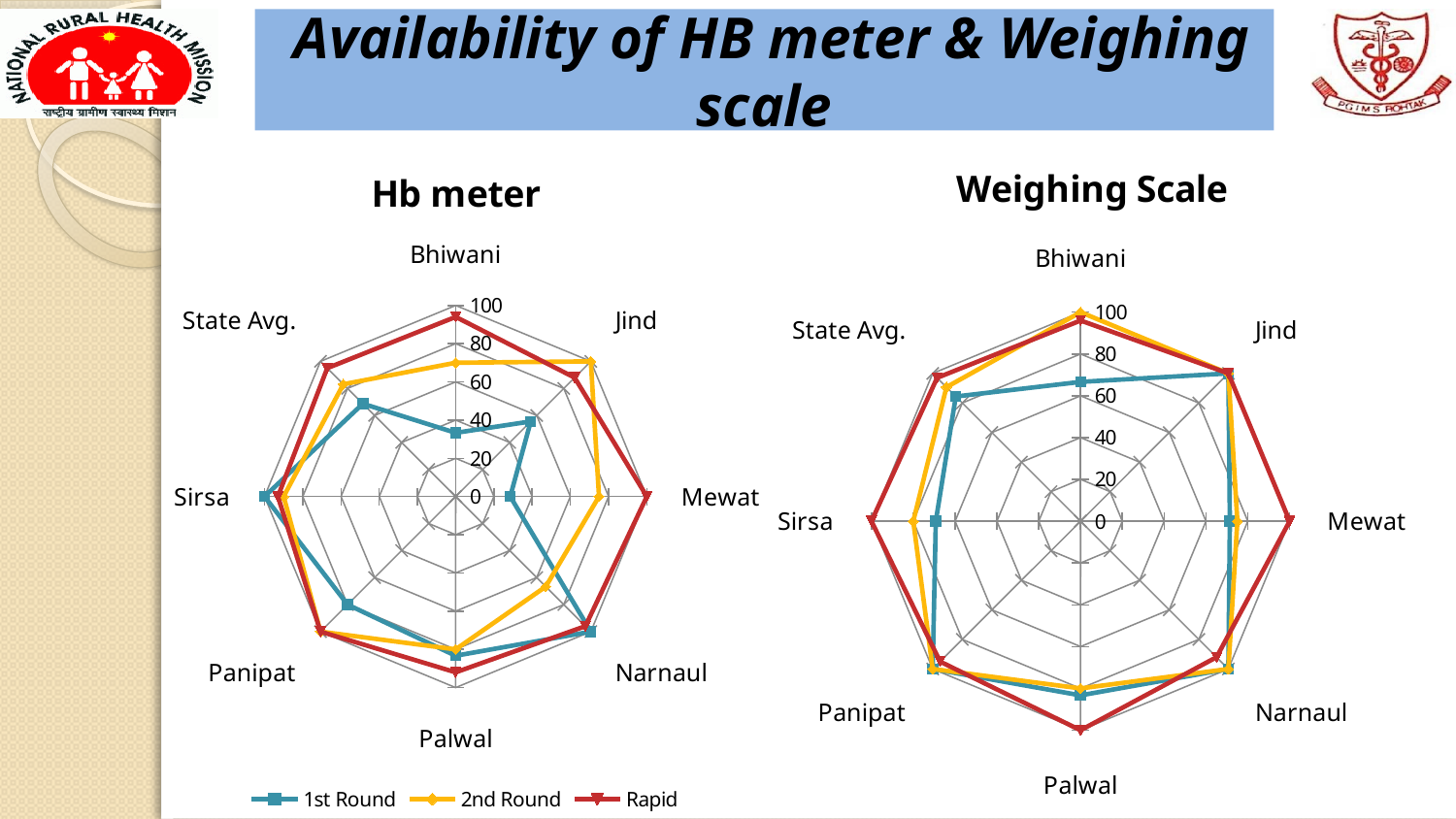
On the Hb meter chart, is the 1st Round value for Sirsa greater or less than 80? greater What kind of chart is the Hb meter chart? Radar chart On the Hb meter chart, is the Rapid value for Bhiwani greater or less than 80? greater On the Weighing Scale chart, is the Rapid value for Palwal greater or less than 80? greater On the Hb meter chart, which series has the larger value for Mewat, 1st Round or Rapid? Rapid How many series does the legend list? 3 On the Hb meter chart, which category has the lowest 1st Round value? Mewat How many categories are plotted on the Weighing Scale chart? 8 What is the title of the chart on the right? Weighing Scale